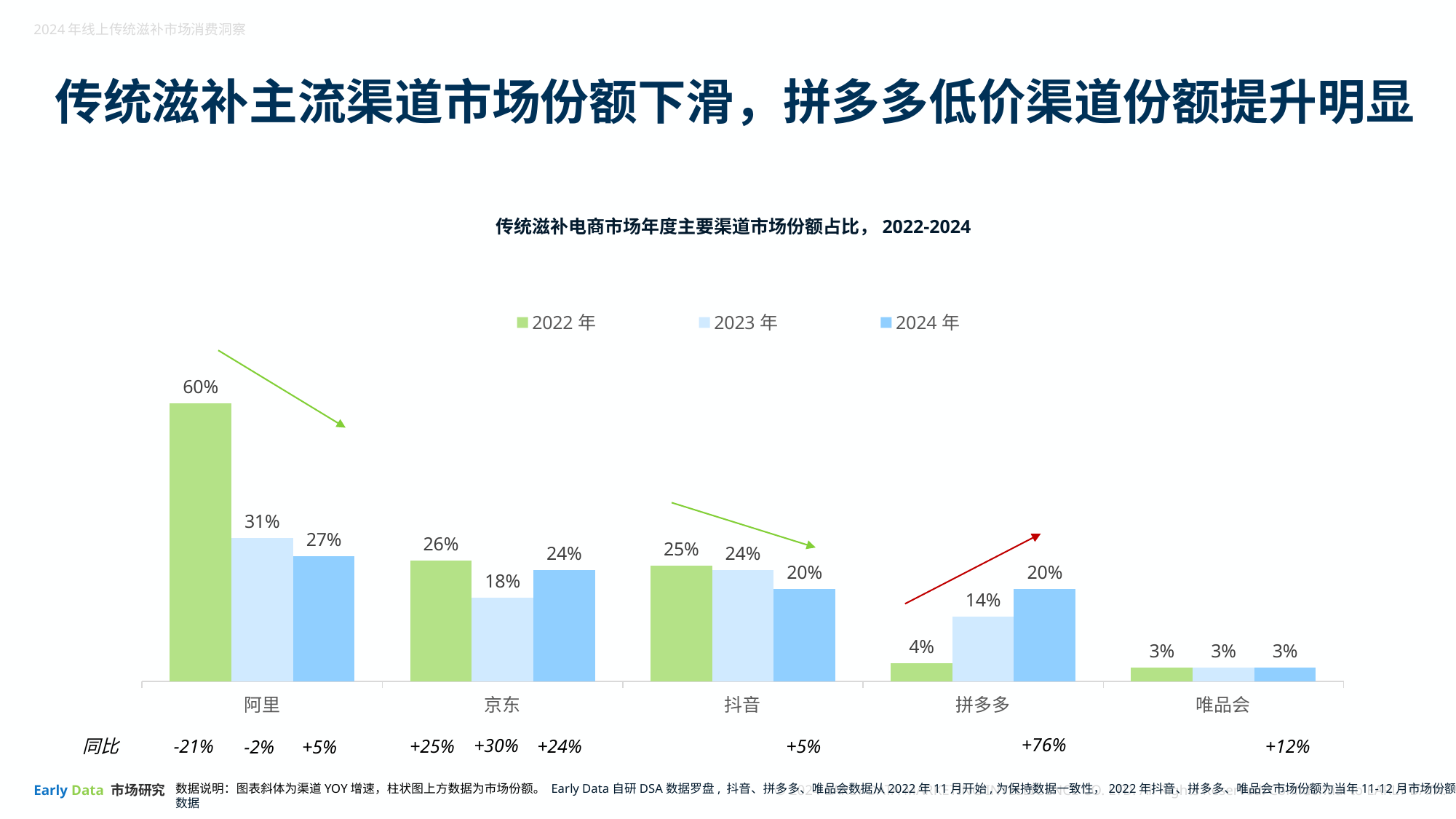
What is the market share of 阿里 in 2022 年? 60% Do 拼多多's market share values rise or fall from 2022 年 to 2024 年? Rise Which channel has the lowest market share in 2024 年? 唯品会 How many channels are shown on the x axis? 5 What is the difference between 阿里's market share in 2022 年 and 2024 年? 33% What is the market share of 京东 in 2023 年? 18% How many series does the legend list? 3 Which is larger: 抖音's 2024 年 share or 京东's 2024 年 share? 京东's 2024 年 share What kind of chart is shown on the slide? Bar chart What is the market share of 拼多多 in 2024 年? 20% What is the title of the chart? 传统滋补电商市场年度主要渠道市场份额占比，2022-2024 Which channel has the highest market share in 2022 年? 阿里